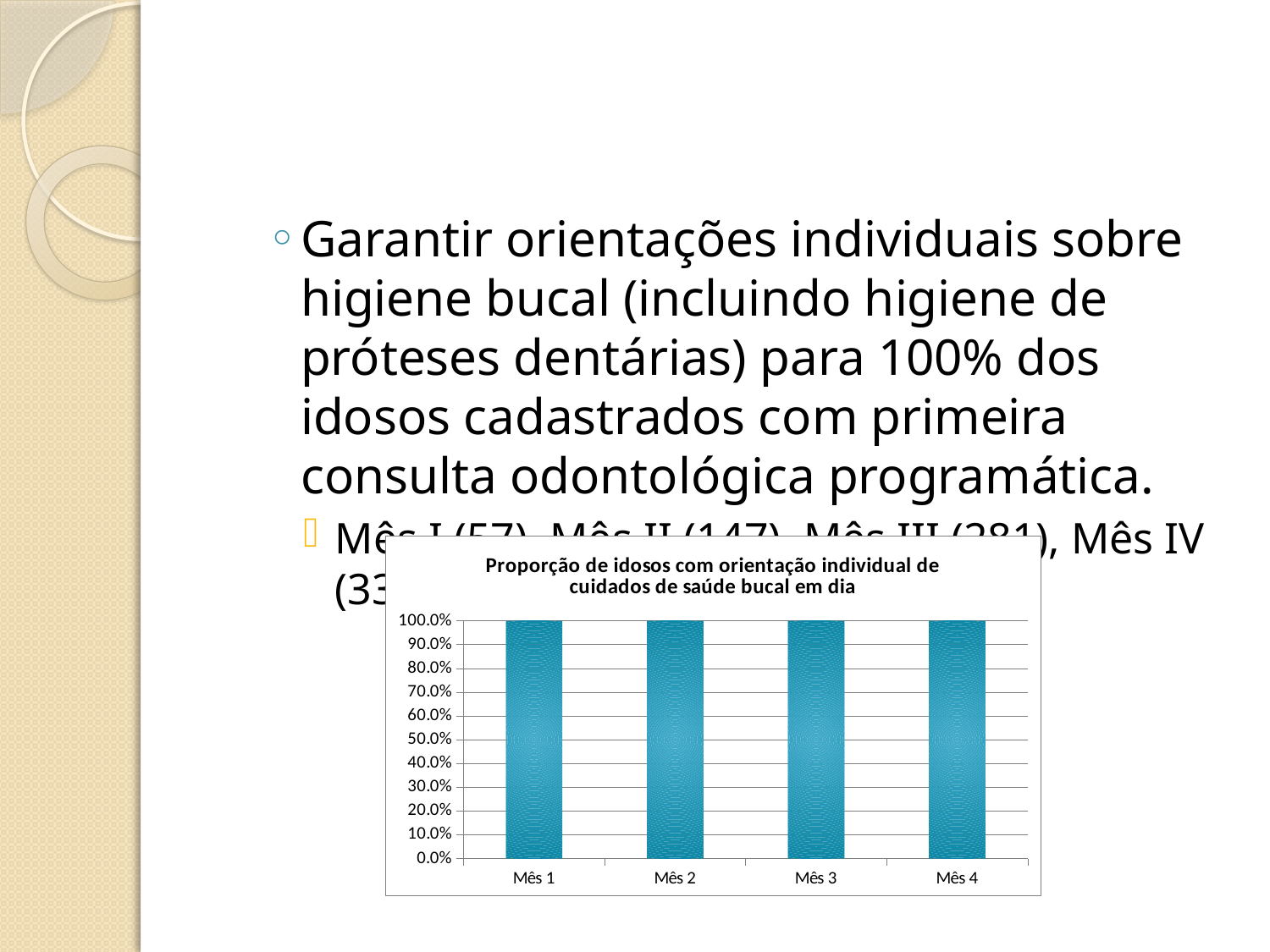
Is the value for Mês 3 greater or less than 50.0%? greater What is the label of the first category on the x axis? Mês 1 What type of chart is shown on the slide? bar chart How many categories are shown on the x axis of the chart? 4 What is the title of the chart? Proporção de idosos com orientação individual de cuidados de saúde bucal em dia What is the highest value shown on the y axis? 100.0%